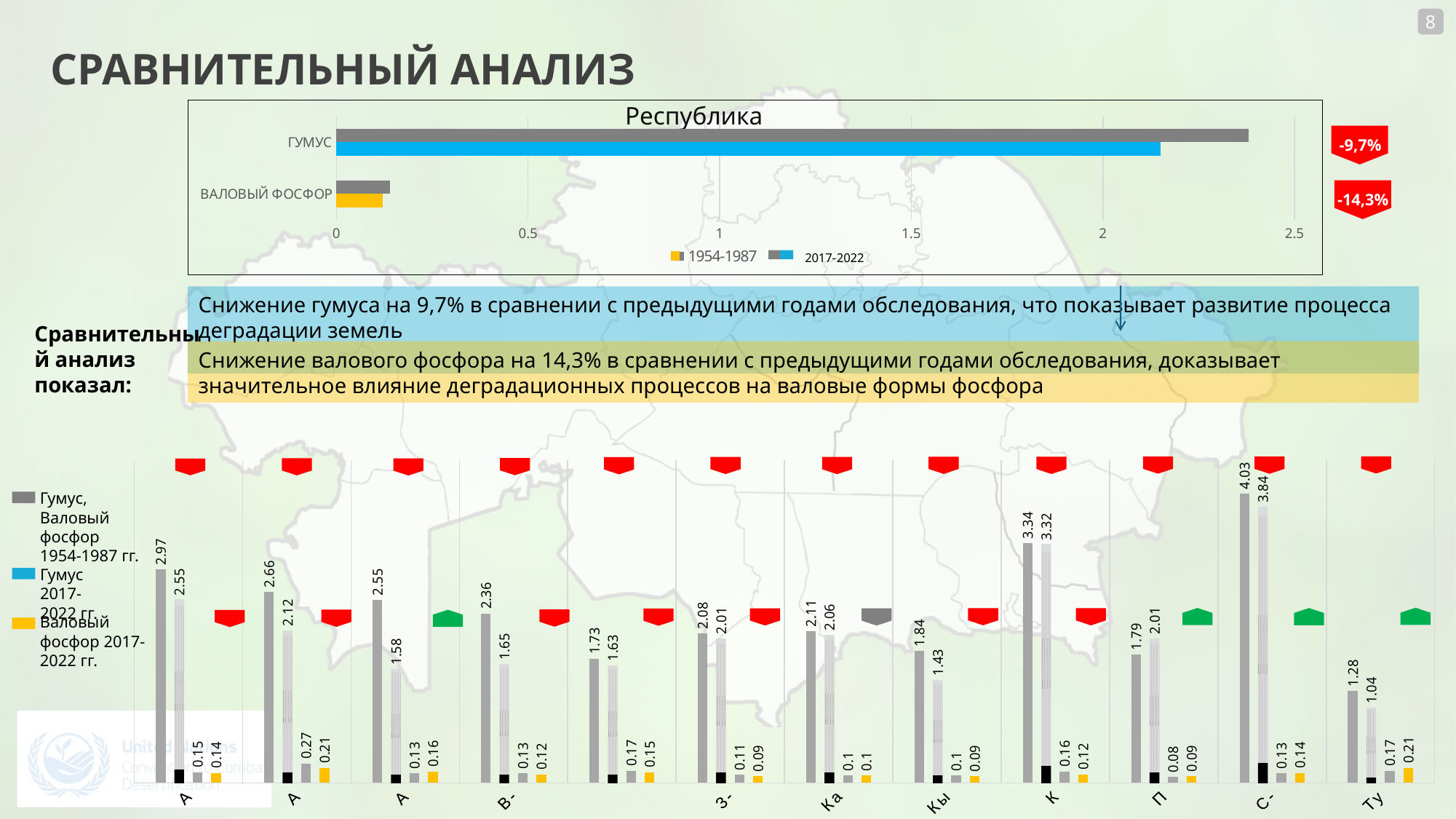
In the top chart titled 'Республика', is the ВАЛОВЫЙ ФОСФОР value for 1954-1987 greater or less than 0.5? less In the top chart titled 'Республика', is the ГУМУС value for 1954-1987 greater or less than 2? greater What percentage change is shown in the red label next to the ГУМУС bars in the top chart? -9,7% In the top chart titled 'Республика', what kind of chart is shown? bar chart In the top chart titled 'Республика', which category has the highest values? ГУМУС In the bottom chart, what is the highest data label value shown? 4.03 In the top chart titled 'Республика', how many series does the legend list? 2 In the bottom chart, how many series does the legend list? 3 In the top chart titled 'Республика', for ГУМУС, which series has the larger value: 1954-1987 or 2017-2022? 1954-1987 In the top chart titled 'Республика', which category has the lowest values? ВАЛОВЫЙ ФОСФОР In the top chart titled 'Республика', how many categories are plotted? 2 In the top chart titled 'Республика', is the ГУМУС value for 2017-2022 greater or less than 2.5? less